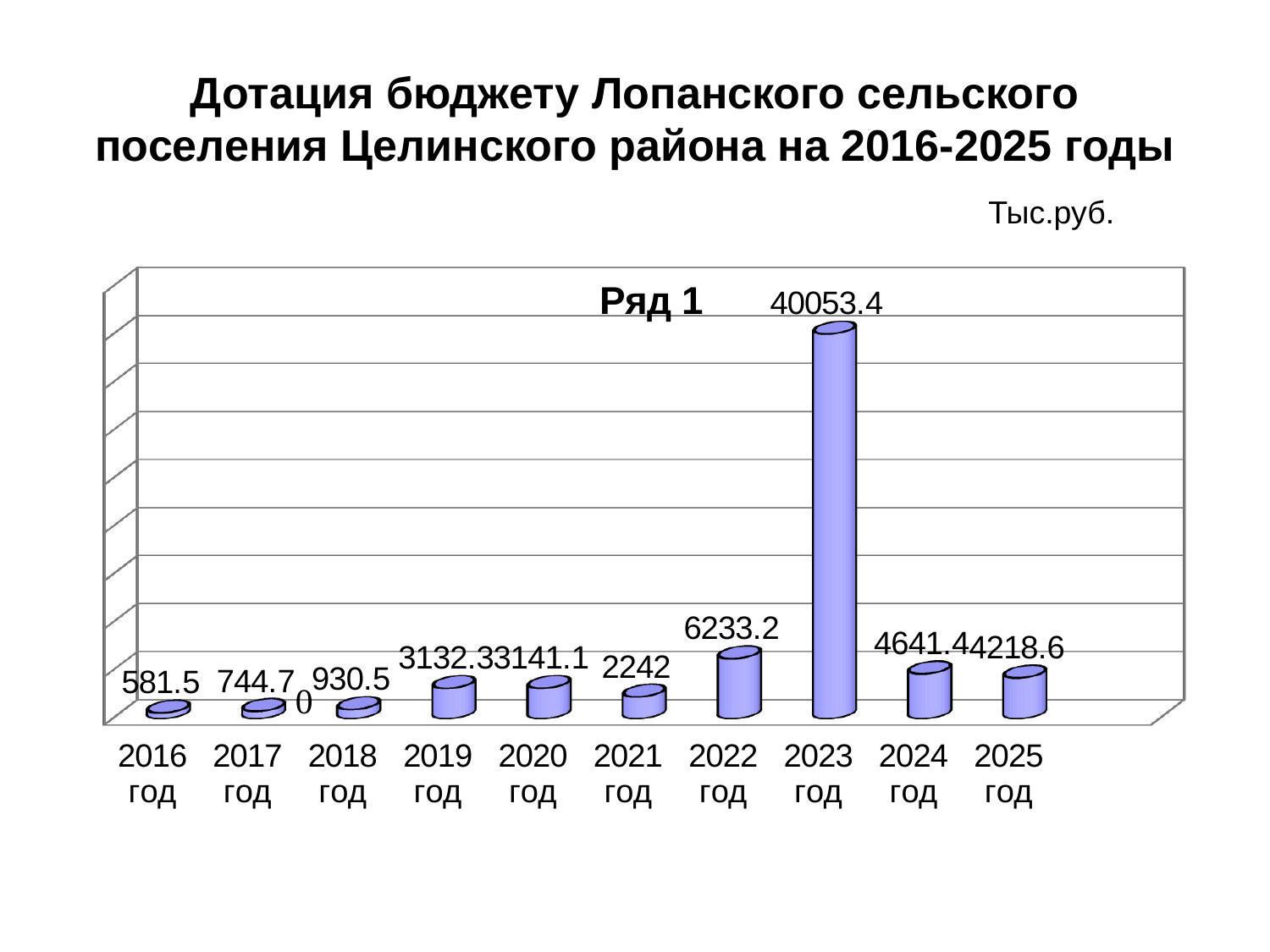
What is the difference between the values for 2018 год and 2016 год? 349 How many years are shown on the x axis? 10 What kind of chart is shown on the slide? Bar chart Which is larger, the value for 2024 год or the value for 2025 год? 2024 год What is the value for 2023 год? 40053.4 What is the value for 2022 год? 6233.2 What is the value for 2016 год? 581.5 What is the value for 2021 год? 2242 What is the difference between the values for 2023 год and 2022 год? 33820.2 What is the value for 2025 год? 4218.6 Which year has the lowest value? 2016 год Which year has the highest value? 2023 год